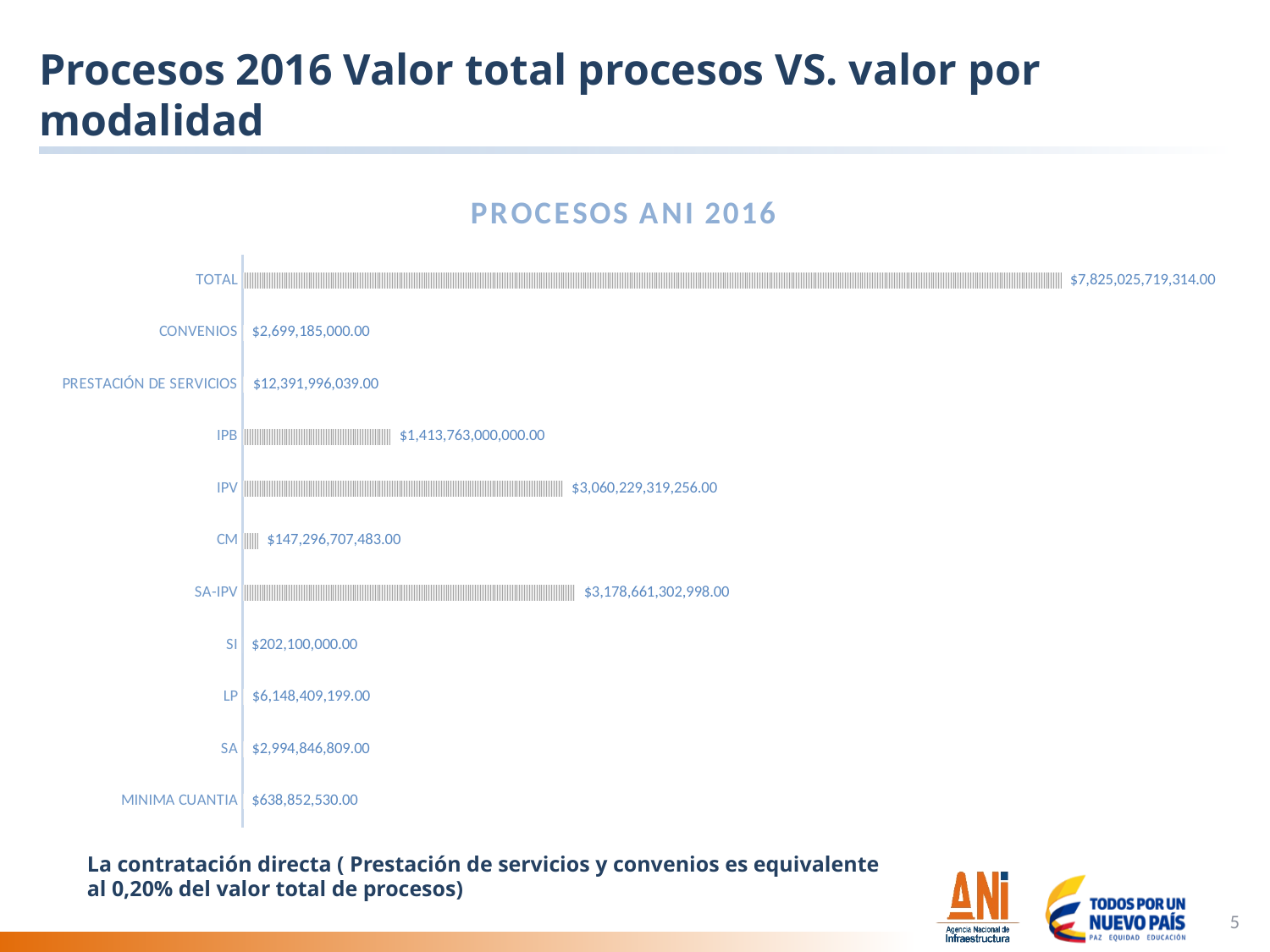
What is the value for TOTAL in the PROCESOS ANI 2016 chart? $7,825,025,719,314.00 What is the value for CM? $147,296,707,483.00 Which is larger, the value for IPB or the value for CM? IPB What type of chart is shown on the slide? Bar chart Excluding TOTAL, which category has the highest value? SA-IPV Which category has the highest value in the chart? TOTAL Which category has the lowest value in the chart? SI What is the value for MINIMA CUANTIA? $638,852,530.00 What is the difference between the values for SA-IPV and IPV? $118,431,983,742.00 How many categories are shown in the chart? 11 What is the value for PRESTACIÓN DE SERVICIOS? $12,391,996,039.00 What is the value for IPV? $3,060,229,319,256.00